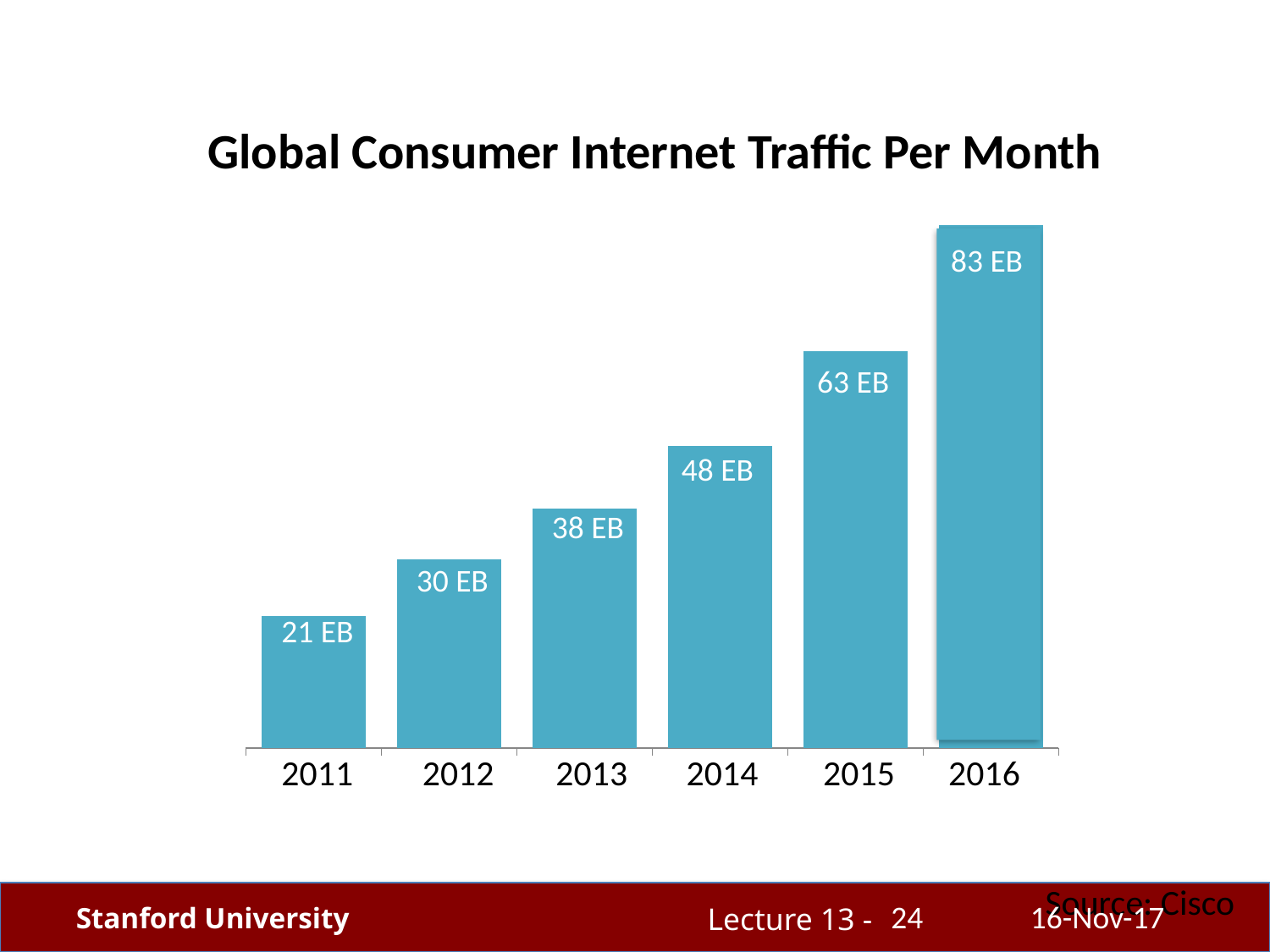
What kind of chart is shown on the slide? Bar chart Which year has the lowest traffic per month? 2011 What is the difference between the 2016 and 2015 values? 20 EB What value is shown for 2014? 48 EB What is the global consumer internet traffic per month for 2011? 21 EB Do the values rise or fall from 2011 to 2016? Rise How much higher is the 2013 value than the 2012 value? 8 EB How many years are shown on the chart? 6 What is the title of the chart? Global Consumer Internet Traffic Per Month What is the traffic per month shown for 2016? 83 EB Which is larger, the value for 2014 or the value for 2015? 2015 Which year has the highest traffic per month? 2016